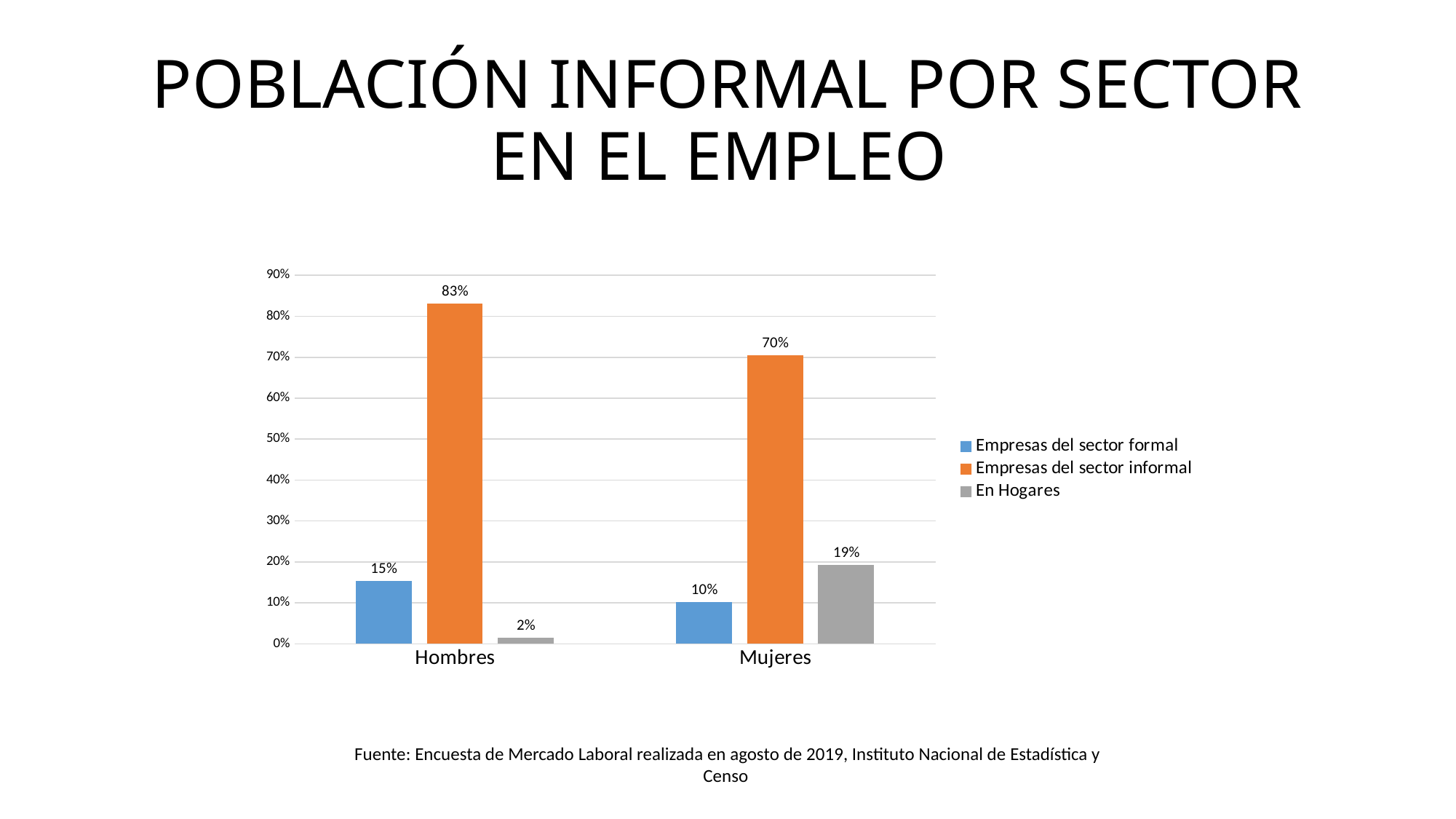
What is the value for En Hogares for Hombres? 2% Which series has the highest value for Hombres? Empresas del sector informal What is the difference between the Empresas del sector informal values for Hombres and Mujeres? 13% What is the value for Empresas del sector formal for Mujeres? 10% What is the value for Empresas del sector informal for Hombres? 83% What kind of chart is shown on the slide? Bar chart What is the value for En Hogares for Mujeres? 19% How many categories are shown on the x axis? 2 How many series does the legend list? 3 Which series has the lowest value for Mujeres? Empresas del sector formal Is the value for Empresas del sector informal for Mujeres greater or less than 60%? greater Which is larger: Empresas del sector formal for Hombres or for Mujeres? Hombres